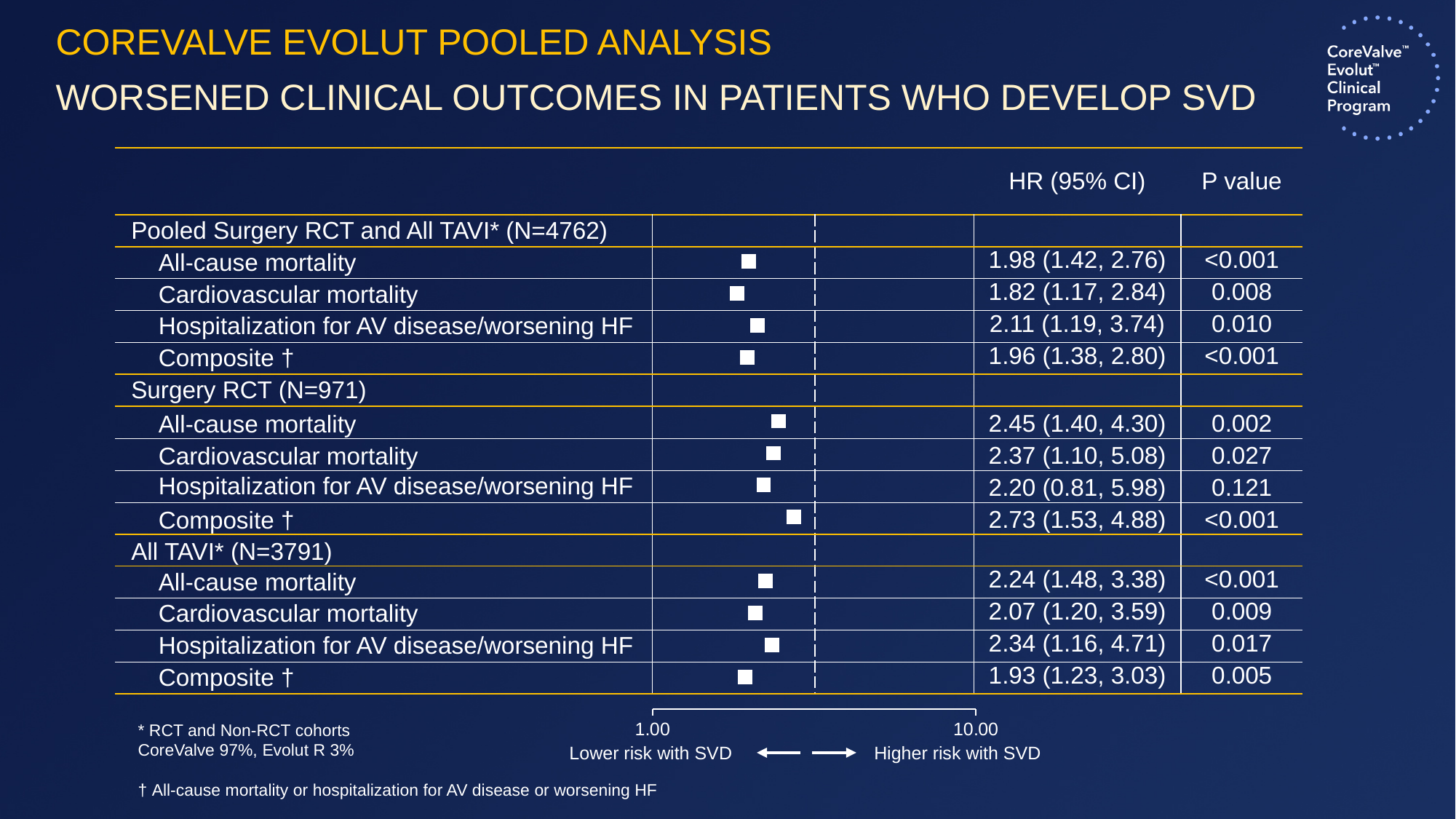
What is the difference between the all-cause mortality hazard ratio in the Surgery RCT group and in the Pooled Surgery RCT and All TAVI group? 0.47 What is the P value for cardiovascular mortality in the All TAVI group? 0.009 Is the hazard ratio for the Composite outcome in the Surgery RCT group greater or less than 1.00? greater Which has the larger hazard ratio for hospitalization for AV disease/worsening HF: the Surgery RCT group or the All TAVI group? All TAVI (2.34) What kind of chart is shown on the slide? Forest plot What is the hazard ratio (95% CI) for the Composite outcome in the All TAVI group? 1.93 (1.23, 3.03) What are the two tick values labelled on the horizontal axis of the forest plot? 1.00 and 10.00 Which outcome and group has the lowest hazard ratio on the forest plot? Cardiovascular mortality, Pooled Surgery RCT and All TAVI (1.82) What is the P value for hospitalization for AV disease/worsening HF in the Surgery RCT group? 0.121 Which outcome and group has the highest hazard ratio on the forest plot? Composite, Surgery RCT (2.73) What is the hazard ratio (95% CI) for all-cause mortality in the Pooled Surgery RCT and All TAVI group? 1.98 (1.42, 2.76) How many outcome rows have a point plotted on the forest plot? 12